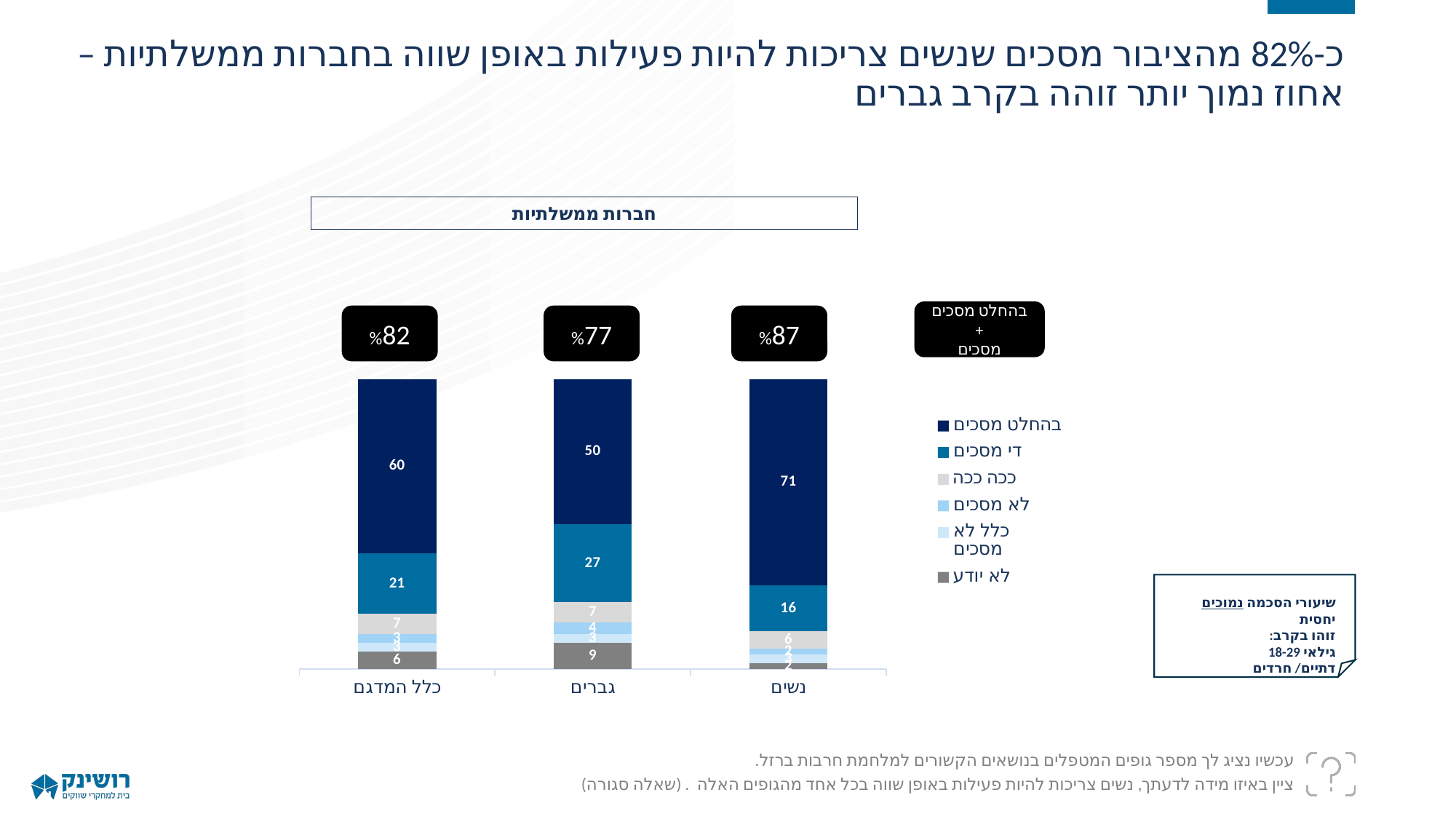
What is the value of לא יודע for כלל המדגם? 6 What type of chart is shown on the slide? stacked bar chart How many categories are shown on the x axis? 3 What combined percentage (בהחלט מסכים + מסכים) is shown above the גברים bar? %77 What is the difference between the בהחלט מסכים values for נשים and גברים? 21 What is the value of די מסכים for גברים? 27 Which is larger: די מסכים for גברים or די מסכים for נשים? גברים Which category has the lowest value for לא יודע? נשים What is the value of בהחלט מסכים for נשים? 71 What is the title shown above the chart? חברות ממשלתיות Which category has the highest value for בהחלט מסכים? נשים How many series does the legend list? 6